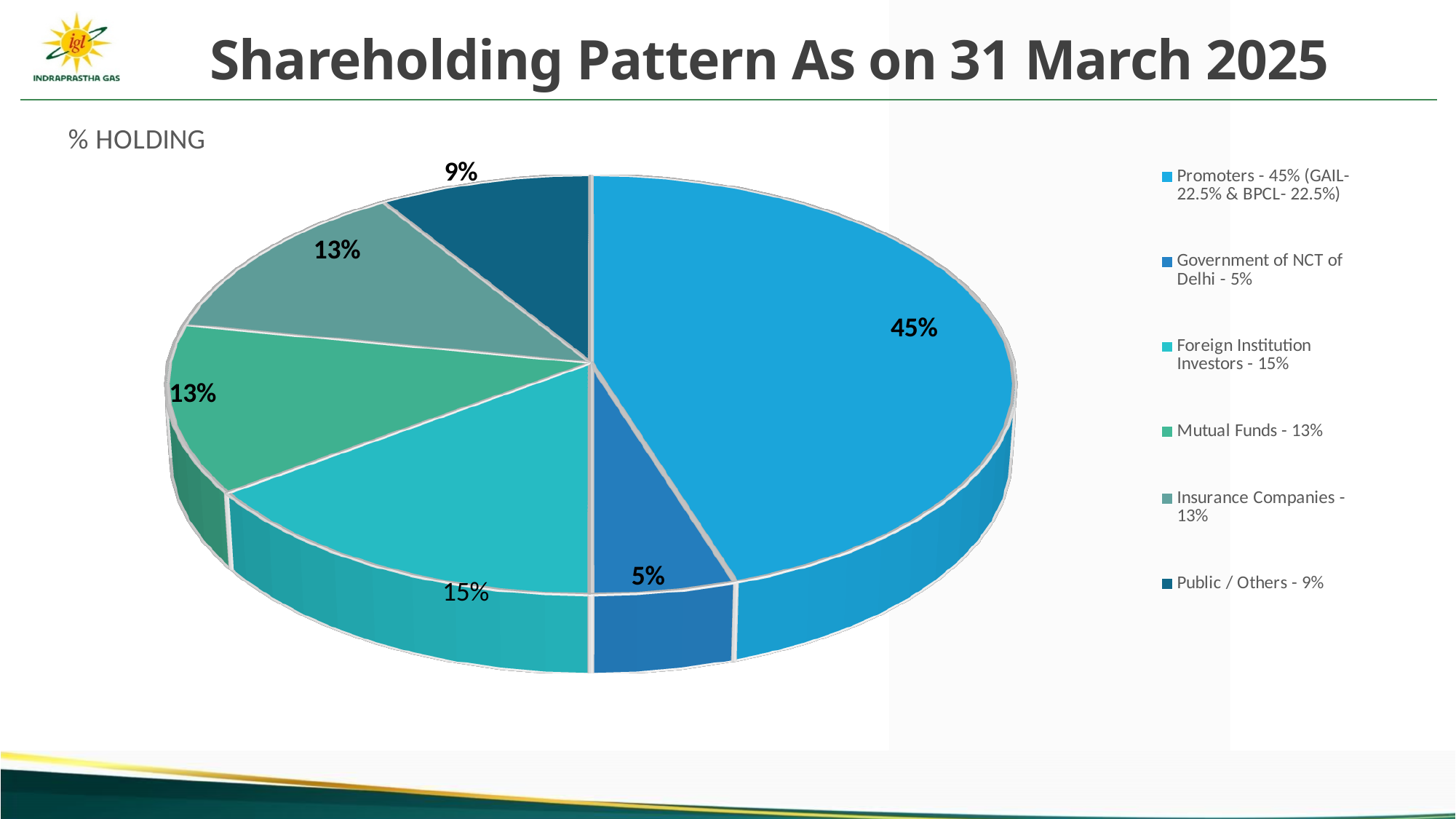
What is the shareholding percentage of Promoters? 45% What is the shareholding percentage of Foreign Institution Investors? 15% What is the shareholding percentage of Government of NCT of Delhi? 5% Which category holds the smallest share? Government of NCT of Delhi How many categories does the legend list? 6 Which is larger, the share of Mutual Funds or the share of Public / Others? Mutual Funds What is the difference between the Promoters share and the Foreign Institution Investors share? 30% What is the title of the chart? % HOLDING According to the legend, what are the holdings of GAIL and BPCL within the Promoters share? GAIL- 22.5% & BPCL- 22.5% Which category holds the largest share? Promoters What type of chart is shown on the slide? Pie chart What is the shareholding percentage of Public / Others? 9%